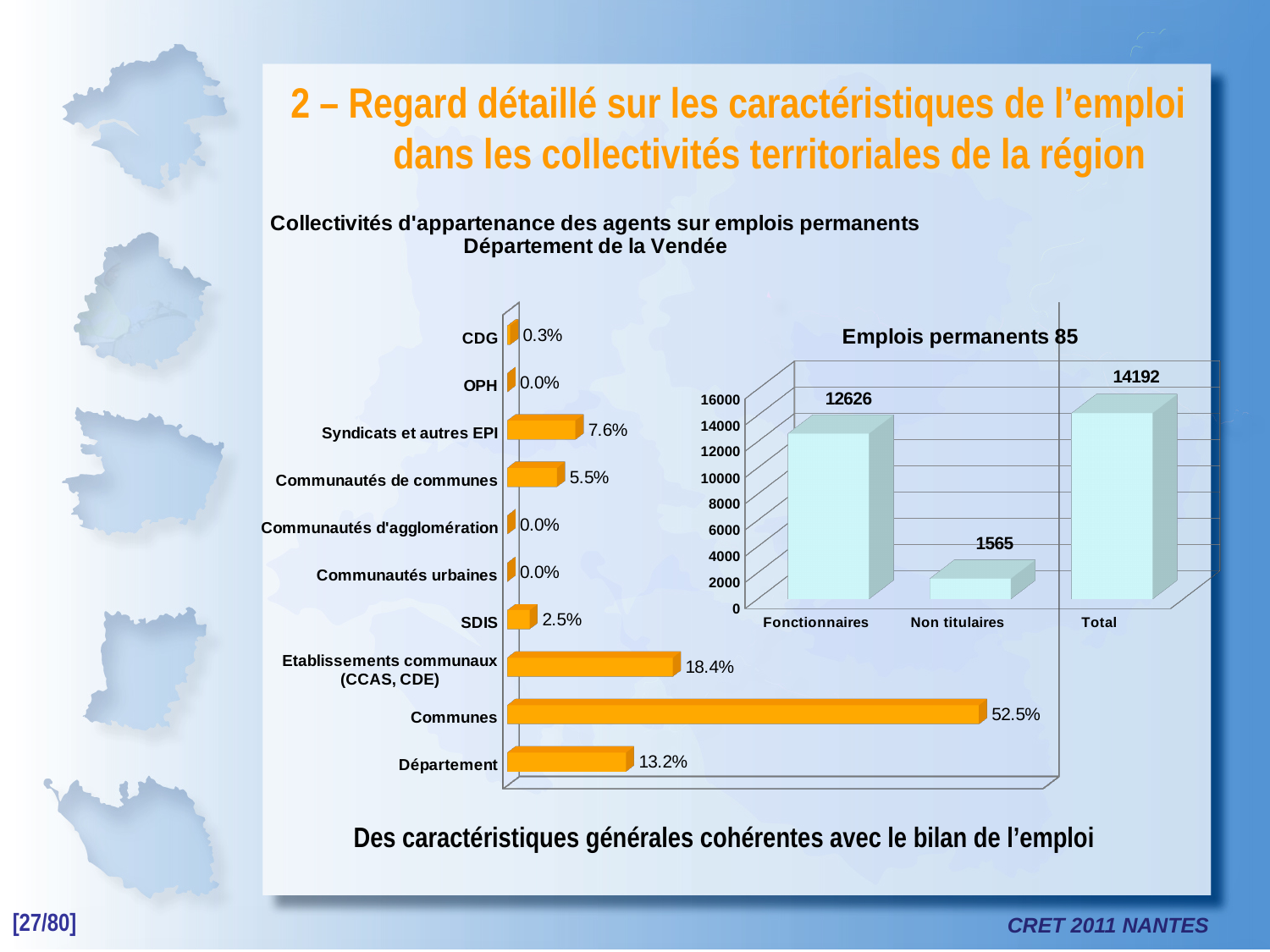
What kind of chart is 'Collectivités d'appartenance des agents sur emplois permanents'? Bar chart In the chart 'Collectivités d'appartenance des agents sur emplois permanents', which is larger: Communautés de communes or SDIS? Communautés de communes In the chart 'Emplois permanents 85', what is the value for Non titulaires? 1565 In the chart 'Emplois permanents 85', which category has the lowest value? Non titulaires How many categories are shown in the chart 'Collectivités d'appartenance des agents sur emplois permanents'? 10 How many categories are shown in the chart 'Emplois permanents 85'? 3 In the chart 'Collectivités d'appartenance des agents sur emplois permanents', which category has the highest value? Communes In the chart 'Emplois permanents 85', what is the difference between Total and Fonctionnaires? 1566 In the chart 'Emplois permanents 85', what is the value for Fonctionnaires? 12626 In the chart 'Collectivités d'appartenance des agents sur emplois permanents', what is the difference between Département and Syndicats et autres EPI? 5.6% In the chart 'Collectivités d'appartenance des agents sur emplois permanents', what is the value for Communes? 52.5% In the chart 'Collectivités d'appartenance des agents sur emplois permanents', what is the value for Etablissements communaux (CCAS, CDE)? 18.4%